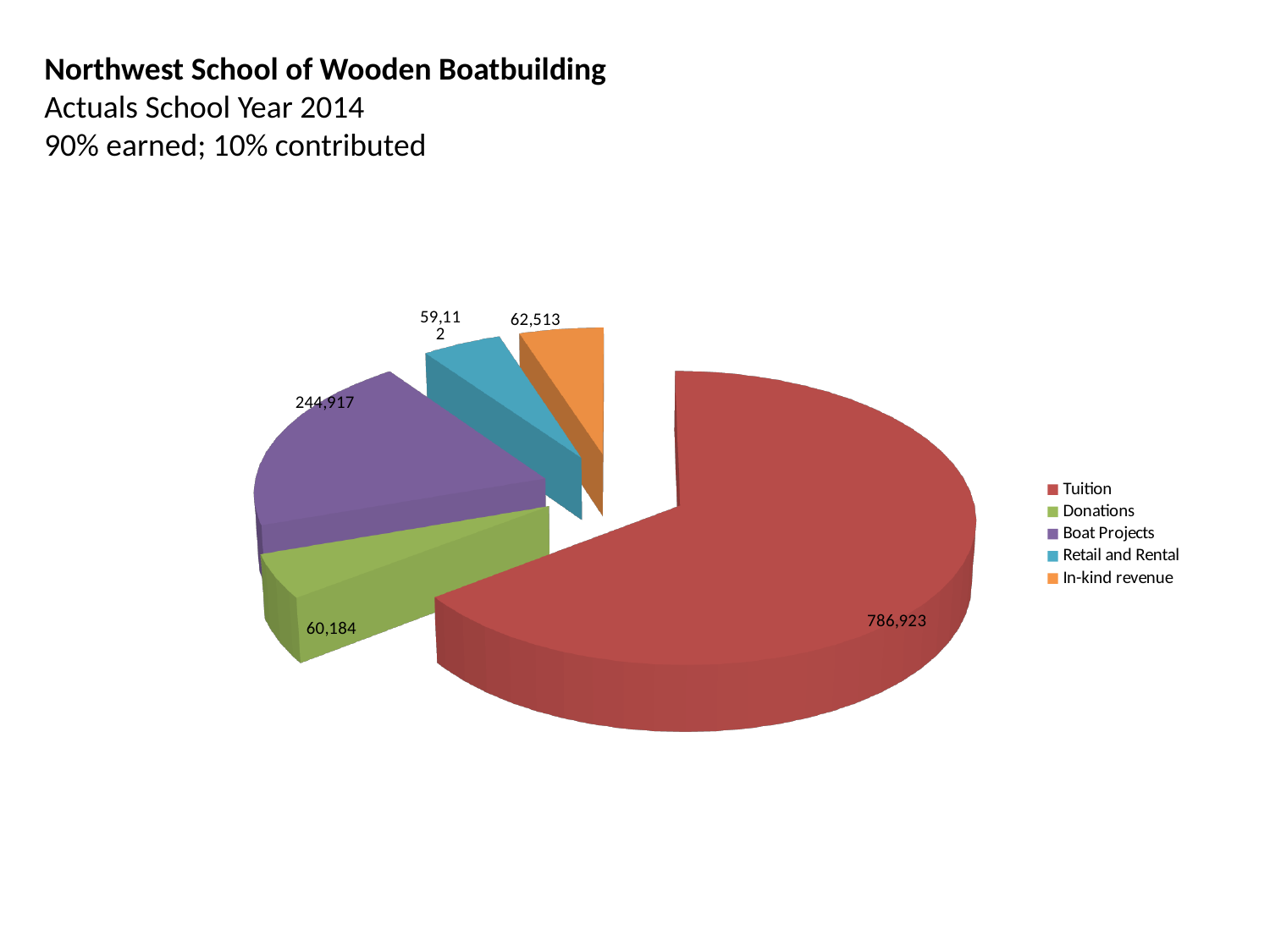
What is the value of the Boat Projects slice? 244,917 Which category has the largest slice of the pie? Tuition Which is larger, Boat Projects or Donations? Boat Projects What is the value of the Tuition slice? 786,923 What colour is the Tuition slice in the legend? Red What is the difference between the Tuition value and the Boat Projects value? 542,006 What is the value of the Donations slice? 60,184 What is the difference between the In-kind revenue value and the Retail and Rental value? 3,401 What kind of chart is shown on the slide? Pie chart How many categories does the pie chart show? 5 What is the value of the In-kind revenue slice? 62,513 Which category has the smallest slice of the pie? Retail and Rental